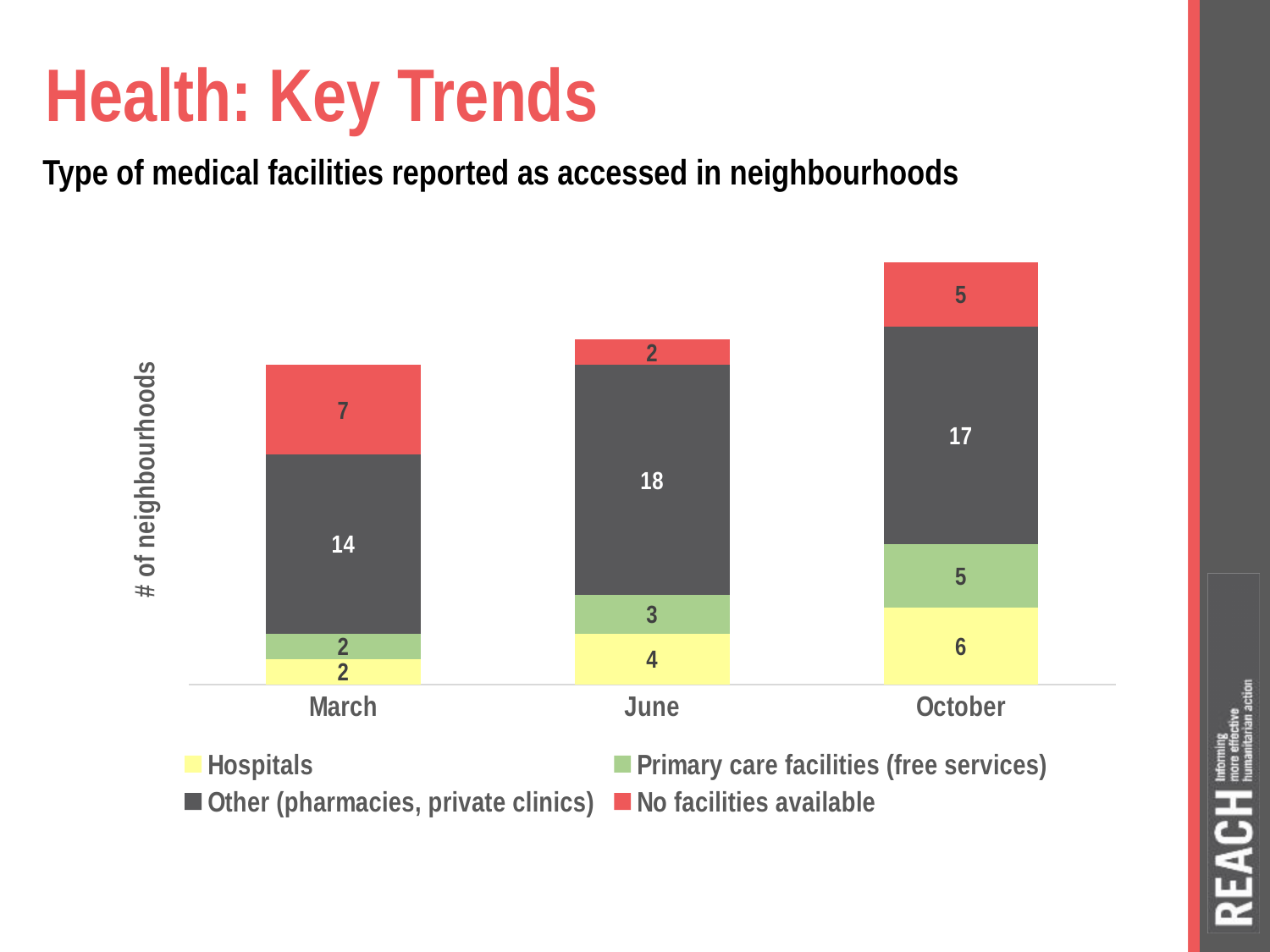
What type of chart is shown on the slide? Stacked bar chart Do the Hospitals values rise or fall from March to October? Rise How many months are shown on the x axis? 3 In which month is the No facilities available value lowest? June What is the value for No facilities available in March? 7 What is the total of the stacked bar for October? 33 Which is larger: the Primary care facilities (free services) value in October or in June? October What is the value for Hospitals in October? 6 In which month is the Hospitals value highest? October What is the value for Other (pharmacies, private clinics) in June? 18 How many series does the legend list? 4 What is the difference between the Other (pharmacies, private clinics) values for June and March? 4